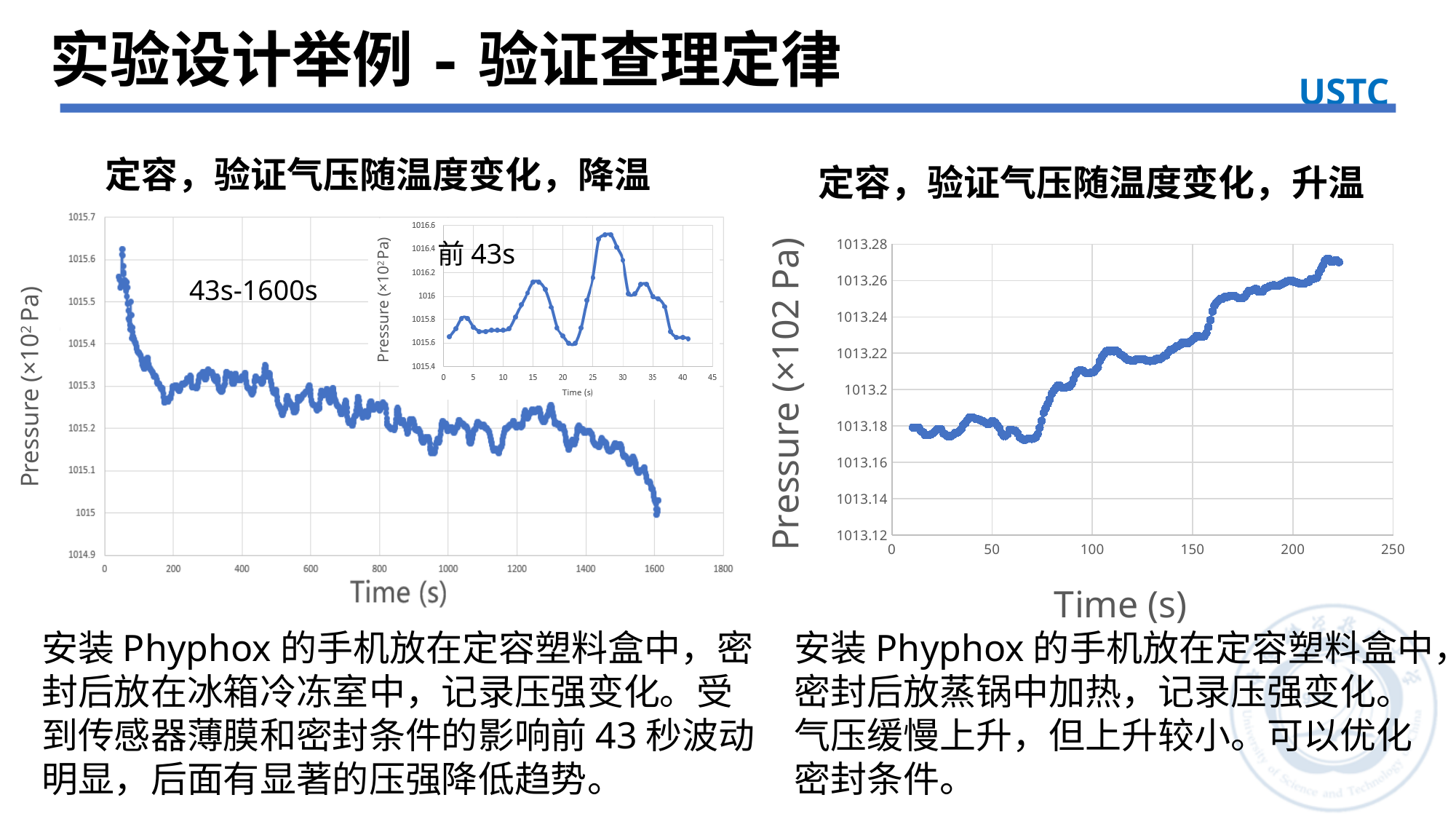
In the right chart (升温), do the pressure values rise or fall overall as time increases? rise In the left chart (降温), which is larger: the pressure at about 200 s or the pressure at about 1600 s? the pressure at about 200 s In the right chart (升温), which is larger: the pressure at about 200 s or the pressure at about 50 s? the pressure at about 200 s In the inset chart labelled 前 43s, is the peak pressure near 27 s greater or less than 1016.4? greater What is the x-axis label of the right chart (升温)? Time (s) In the left chart (降温), is the pressure at about 1600 s greater or less than 1015.1? less What is the highest tick value shown on the x axis of the left chart (降温)? 1800 What kind of chart is the left chart titled 定容，验证气压随温度变化，降温? line chart In the right chart (升温), is the pressure at about 50 s greater or less than 1013.2? less In the left chart (降温), do the pressure values rise or fall overall as time increases from 43s to 1600s? fall